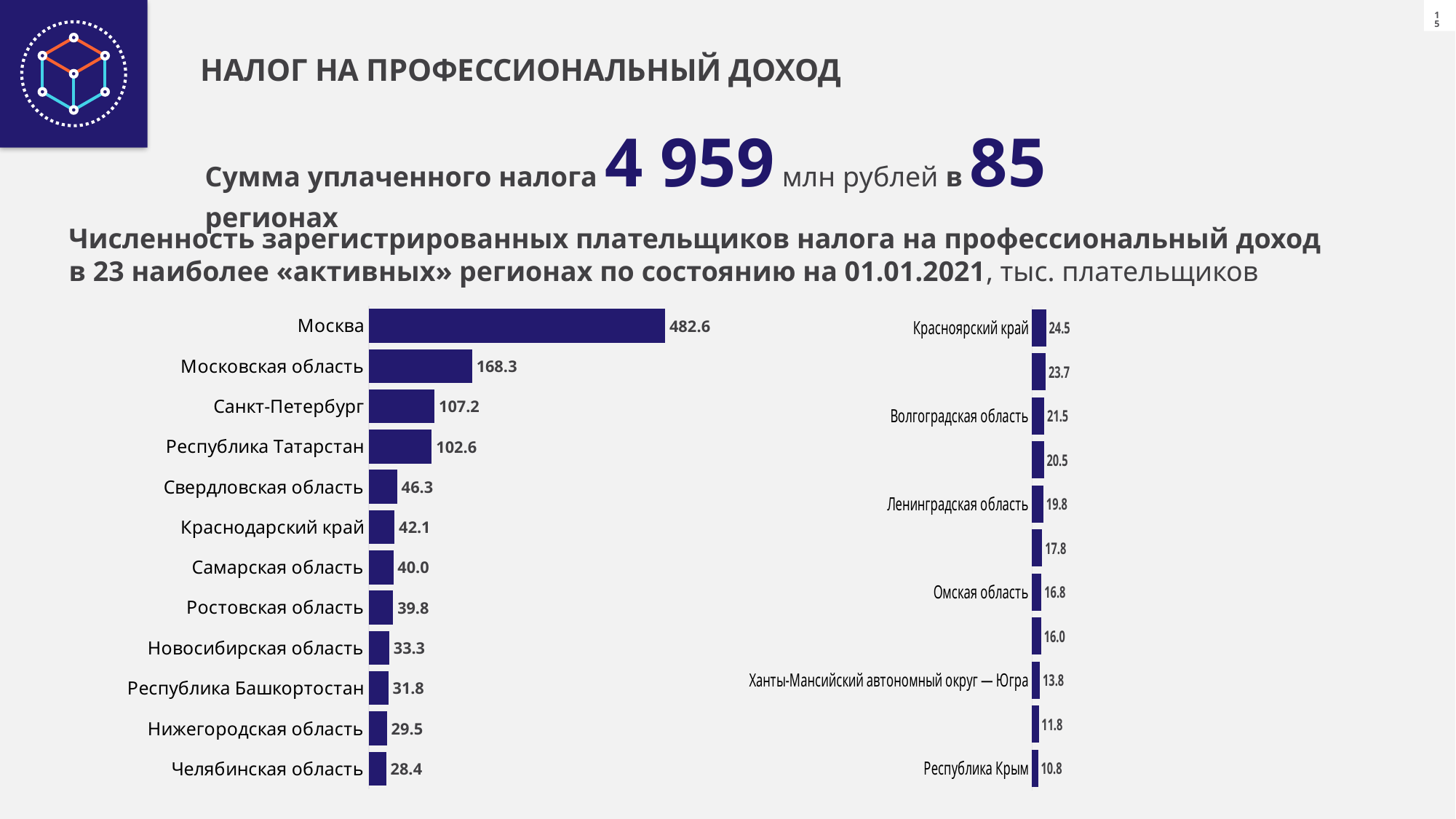
In the right chart, what is the value for Красноярский край? 24.5 In the left chart, which is larger: the value for Свердловская область or Краснодарский край? Свердловская область In the left chart, which region has the highest value? Москва In the left chart, what is the value for Москва? 482.6 In the left chart, what is the difference between the values for Москва and Московская область? 314.3 What kind of chart is the left chart? Bar chart How many regions are shown in the left chart? 12 In the left chart, which region has the lowest value? Челябинская область In the right chart, which is larger: the value for Ленинградская область or Омская область? Ленинградская область In the left chart, what is the value for Санкт-Петербург? 107.2 In the right chart, what is the value for Республика Крым? 10.8 In the right chart, what is the difference between the values for Красноярский край and Республика Крым? 13.7